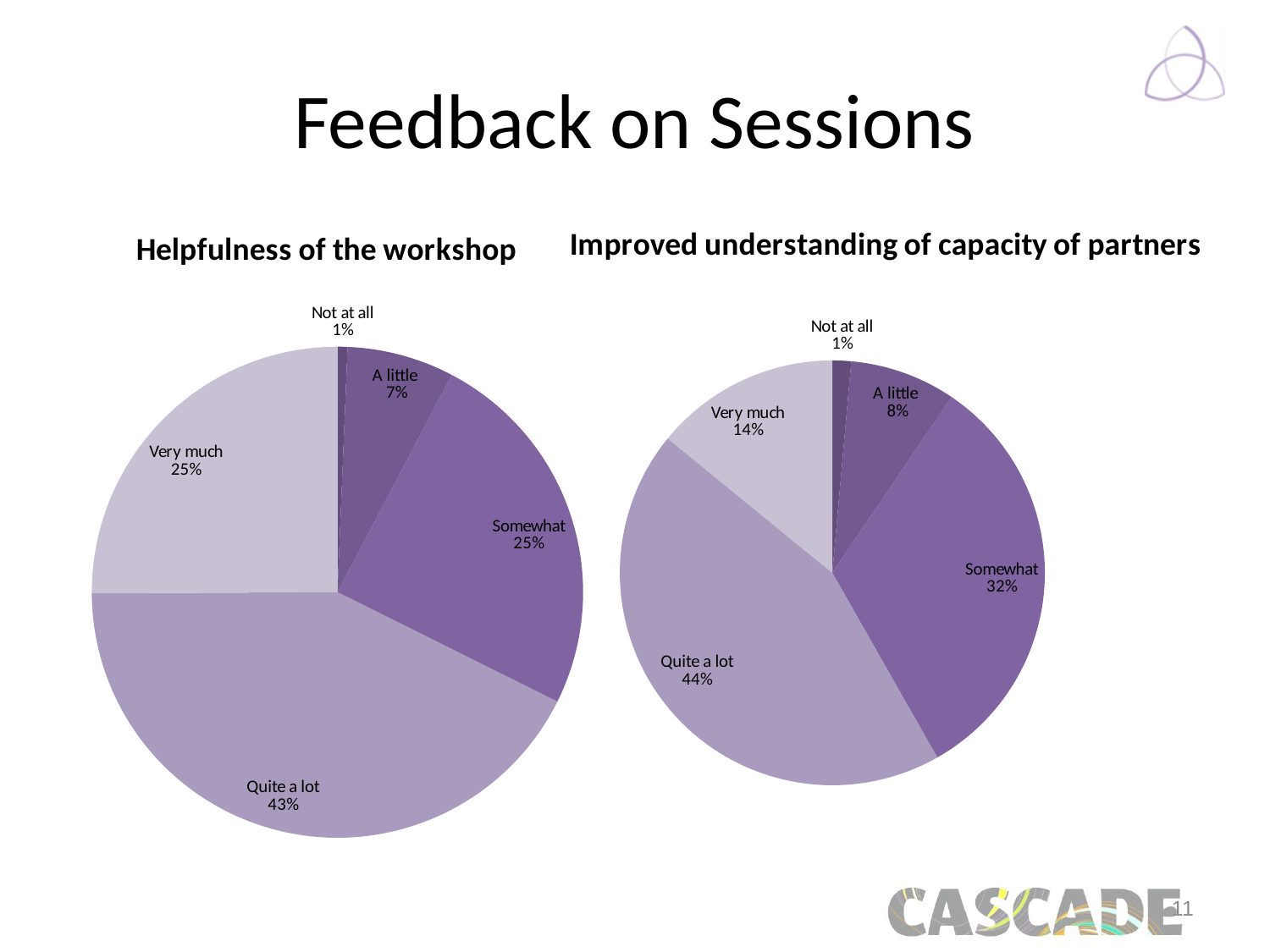
In the 'Helpfulness of the workshop' chart, what share of responses is 'Quite a lot'? 43% In the 'Improved understanding of capacity of partners' chart, what is the difference between 'Quite a lot' and 'Somewhat'? 12% What kind of chart is the 'Improved understanding of capacity of partners' chart? Pie chart In the 'Helpfulness of the workshop' chart, which category has the largest slice? Quite a lot How many categories does the 'Helpfulness of the workshop' chart show? 5 In the 'Improved understanding of capacity of partners' chart, what share of responses is 'Somewhat'? 32% In the 'Improved understanding of capacity of partners' chart, which category has the smallest slice? Not at all In the 'Helpfulness of the workshop' chart, what is the difference between 'Quite a lot' and 'Very much'? 18% What is the title of the chart on the left of the slide? Helpfulness of the workshop In the 'Helpfulness of the workshop' chart, what is the value for 'A little'? 7% In the 'Improved understanding of capacity of partners' chart, which is larger: 'Somewhat' or 'Very much'? Somewhat In the 'Improved understanding of capacity of partners' chart, what is the value for 'Very much'? 14%